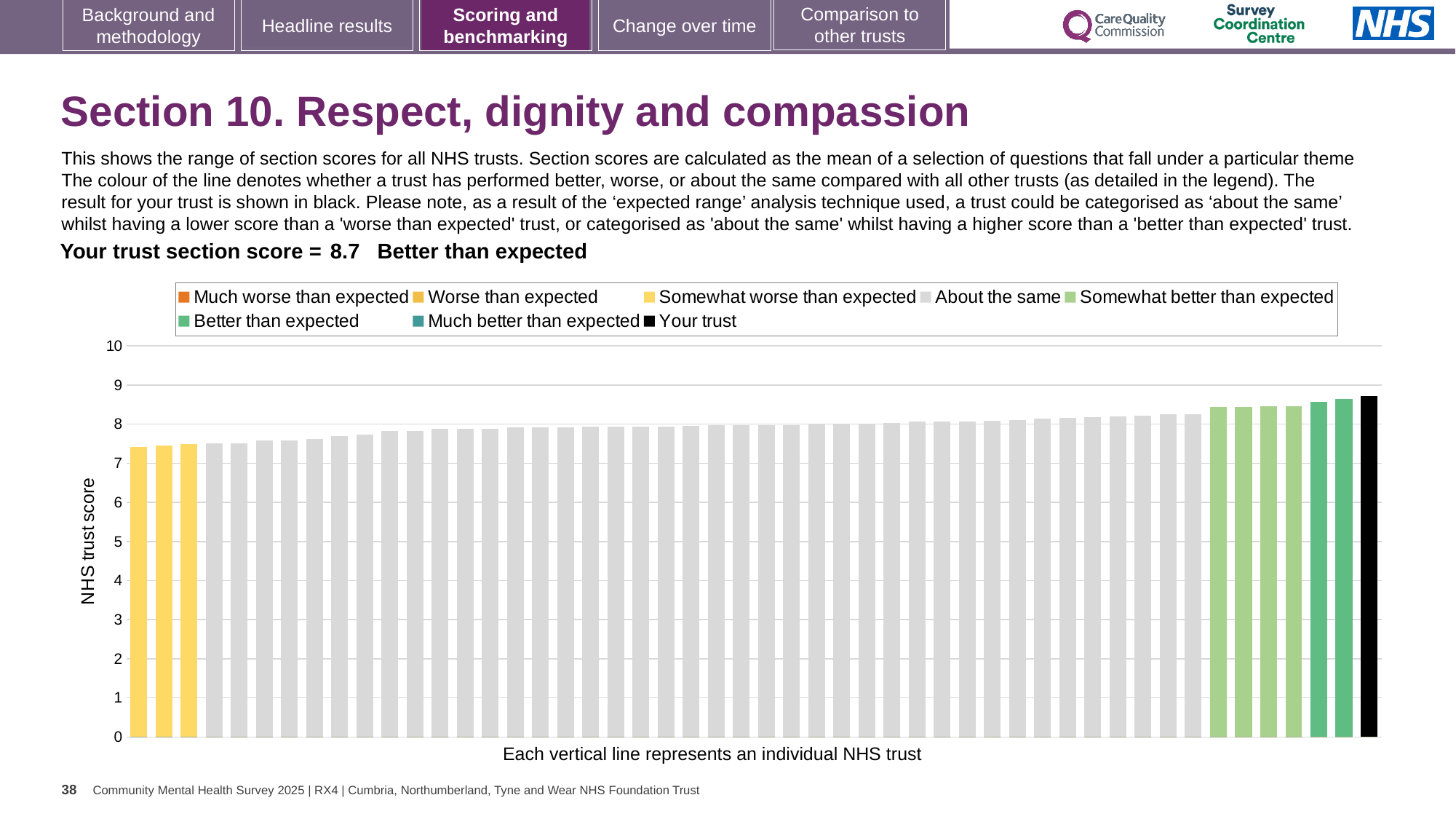
How many entries does the chart legend list? 8 What is the label on the y axis of the chart? NHS trust score Do the bar values rise or fall from left to right along the x axis? rise How many bars are coloured as 'Somewhat better than expected'? 4 How many bars are coloured as 'Somewhat worse than expected'? 3 What kind of chart is shown on the slide? bar chart What is the section score for your trust? 8.7 How many bars are coloured as 'Better than expected'? 2 Is the value for Your trust greater or less than 8? greater Is the value of the lowest bar greater or less than 7? greater Is the value of the lowest bar greater or less than 8? less Which bar in the chart is the highest? Your trust